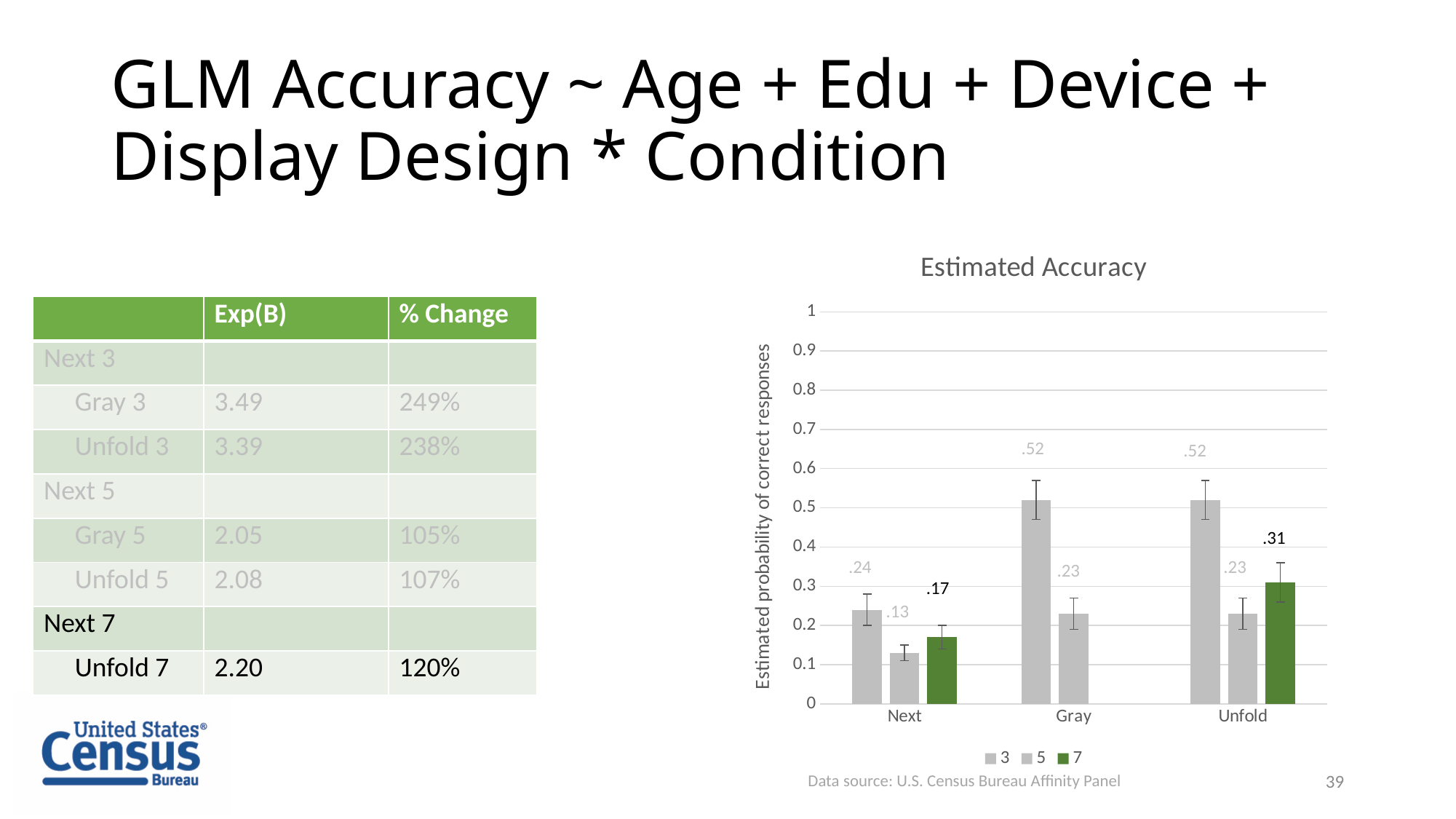
Which category has the highest value for series 7? Unfold What is the value for series 5 in the Next category? .13 What kind of chart is shown on the slide? bar chart What is the value for series 3 in the Gray category? .52 How many categories are shown on the x axis of the chart? 3 What is the title of the chart? Estimated Accuracy Which category has the lowest value for series 7? Next Is the value for series 3 in the Unfold category greater or less than 0.4? greater In the Next category, which is larger: the value for series 3 or the value for series 7? series 3 What is the value for series 7 in the Unfold category? .31 How many series does the chart legend list? 3 What is the difference between the series 3 and series 5 values in the Gray category? .29